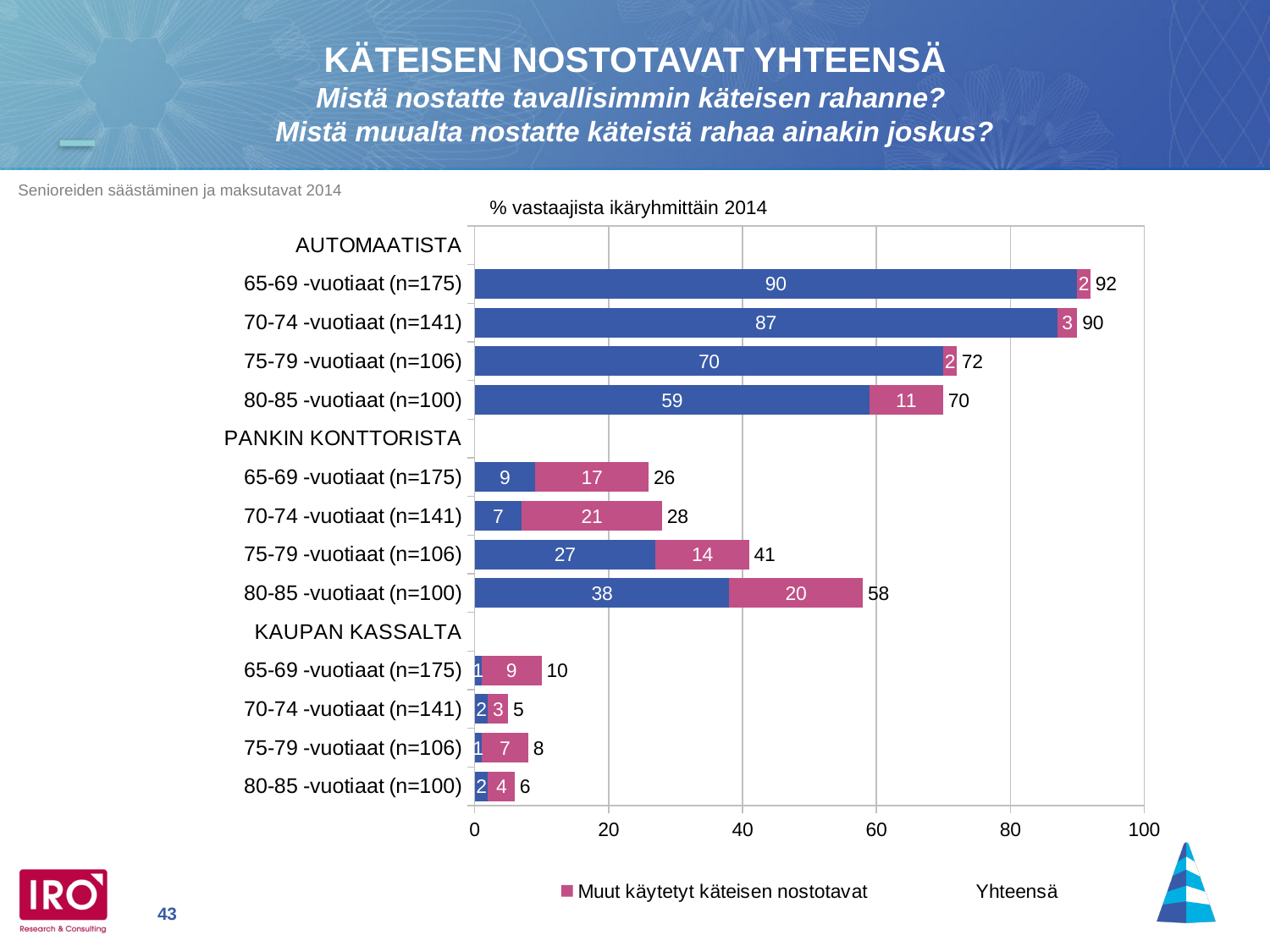
What is the subtitle printed above the chart area? % vastaajista ikäryhmittäin 2014 What is the difference between the totals for AUTOMAATISTA 65-69 -vuotiaat (92) and AUTOMAATISTA 80-85 -vuotiaat (70)? 22 How do the AUTOMAATISTA totals change as the age group gets older, from 65-69 to 80-85? They decrease What type of chart is shown on the slide? Stacked bar chart Under PANKIN KONTTORISTA, which is larger: the total for 65-69 -vuotiaat or the total for 70-74 -vuotiaat? 70-74 -vuotiaat What is the value of the blue segment for PANKIN KONTTORISTA, 75-79 -vuotiaat (n=106)? 27 Which age group has the highest total under PANKIN KONTTORISTA? 80-85 -vuotiaat (n=100) How many age-group bars are plotted in the chart in total? 12 What is the total of the stacked bar for KAUPAN KASSALTA, 65-69 -vuotiaat (n=175)? 10 Which age group has the lowest total under KAUPAN KASSALTA? 70-74 -vuotiaat (n=141) What is the value of the pink 'Muut käytetyt käteisen nostotavat' segment for AUTOMAATISTA, 80-85 -vuotiaat (n=100)? 11 What is the total (Yhteensä) value for AUTOMAATISTA, 65-69 -vuotiaat (n=175)? 92